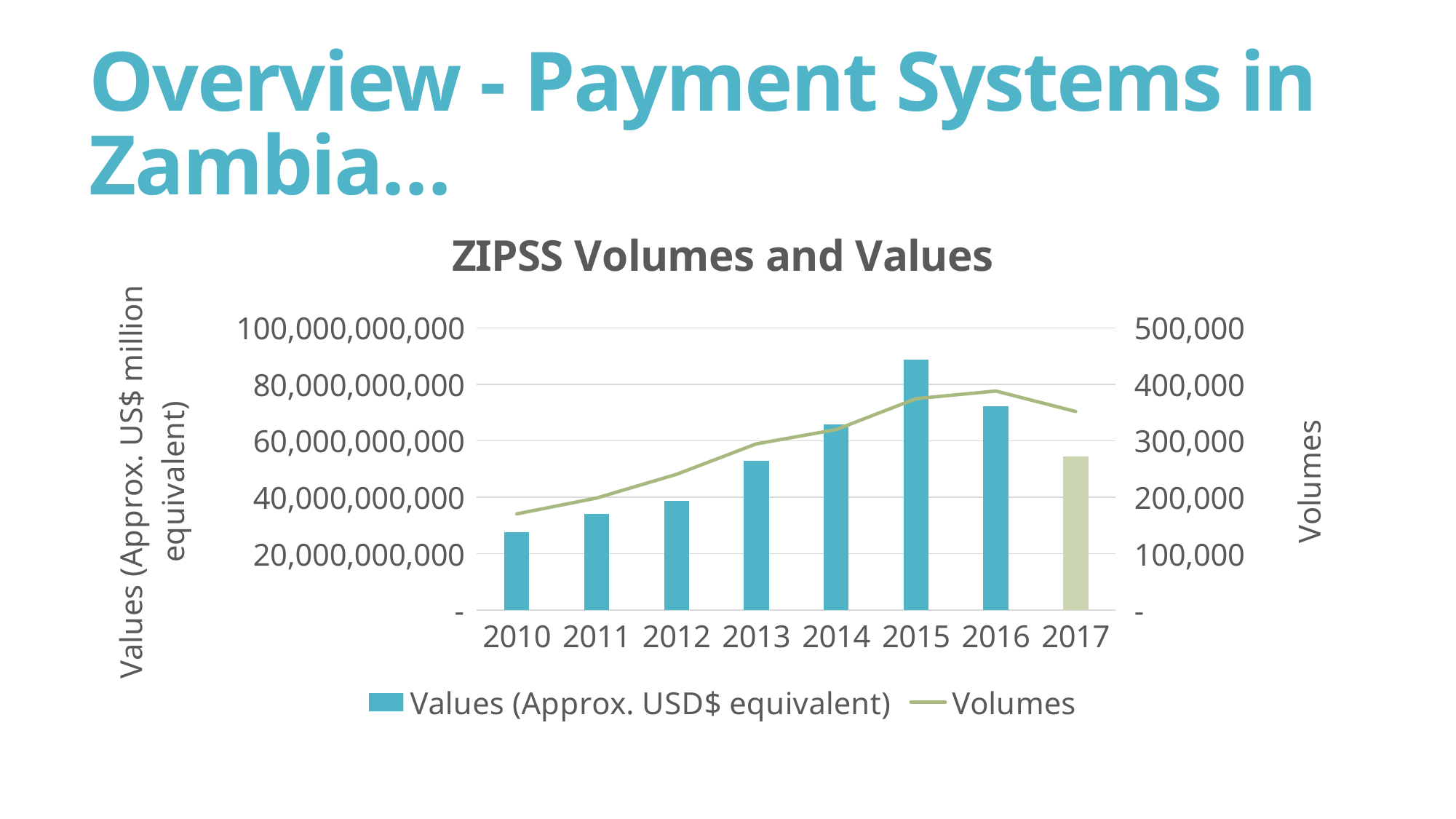
Which year has a larger Values bar, 2016 or 2017? 2016 Which year has the lowest bar for Values (Approx. USD$ equivalent)? 2010 What is the title of the chart? ZIPSS Volumes and Values How many series does the legend list? 2 Is the Values bar for 2010 greater or less than 40,000,000,000? less Do the Values bars rise or fall from 2010 to 2015? rise Which year has the highest bar for Values (Approx. USD$ equivalent)? 2015 What kind of chart is used to show the Values series? bar chart Is the Values bar for 2015 greater or less than 80,000,000,000? greater Is the Volumes value for 2016 greater or less than 300,000? greater What label is shown on the right-hand vertical axis? Volumes How many years are shown on the x axis of the chart? 8